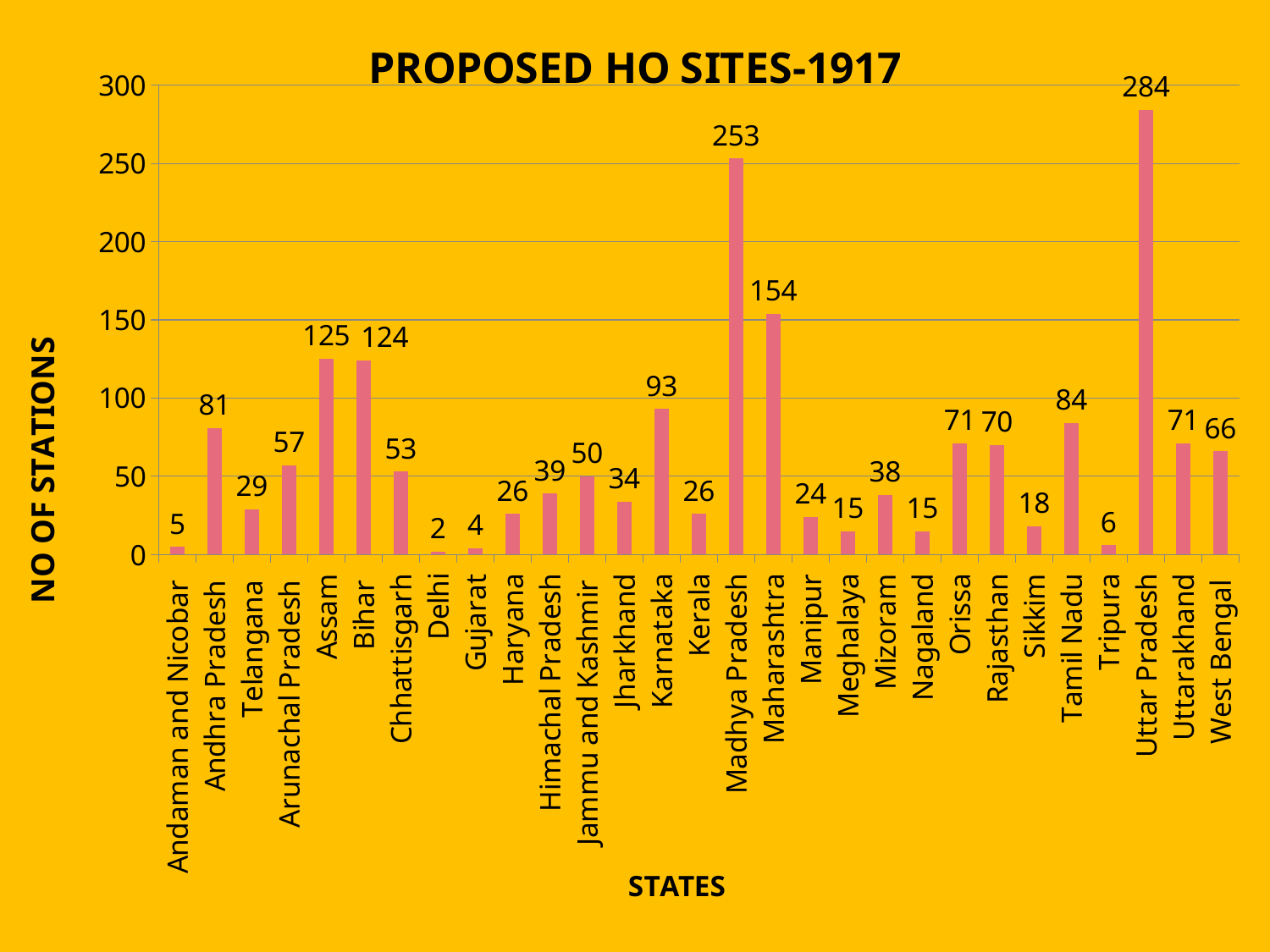
What is the number of stations for Karnataka? 93 What is the number of stations for Sikkim? 18 What is the number of stations for Madhya Pradesh? 253 What is the difference in number of stations between Assam and Bihar? 1 What is the difference in number of stations between Uttar Pradesh and Madhya Pradesh? 31 How many states are shown on the x axis? 29 Which state has the lowest number of stations? Delhi Is the value for Tamil Nadu greater or less than 50? greater Which state has the highest number of stations? Uttar Pradesh Which has more stations, Maharashtra or Karnataka? Maharashtra What kind of chart is shown on the slide? Bar chart What is the title of the chart? PROPOSED HO SITES-1917